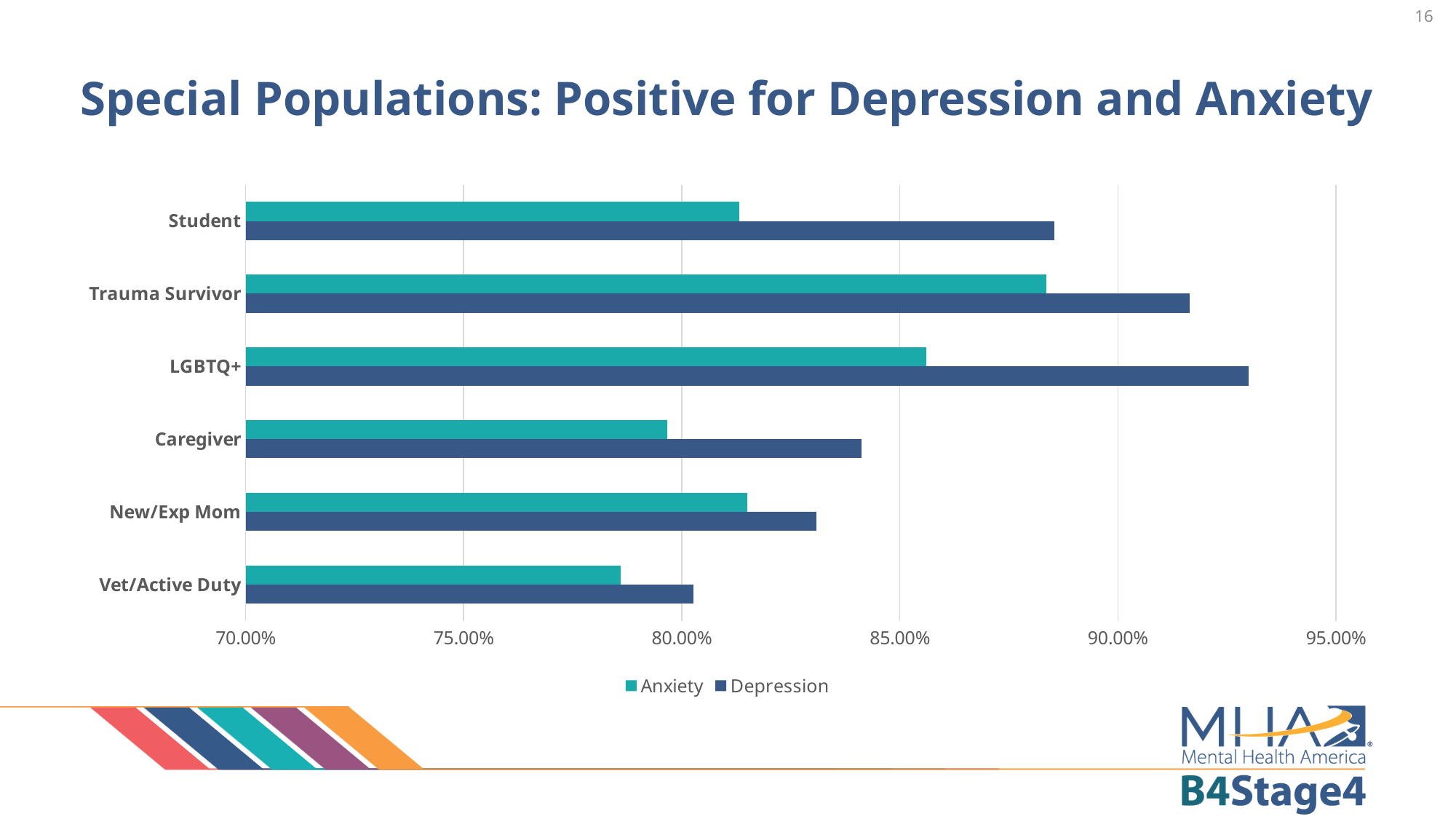
How many series does the legend list? 2 Is the Depression value for LGBTQ+ greater or less than 90.00%? greater Which population has the lowest Anxiety value? Vet/Active Duty Which is larger: the Depression value for Student or the Depression value for Caregiver? Student Which population has the highest Anxiety value? Trauma Survivor Which population has the highest Depression value? LGBTQ+ Is the Depression value for Student greater or less than 85.00%? greater Is the Anxiety value for Caregiver greater or less than 80.00%? less What kind of chart is shown on the slide? bar chart What is the title of the chart on the slide? Special Populations: Positive for Depression and Anxiety Which population has the lowest Depression value? Vet/Active Duty How many population categories are shown on the chart? 6